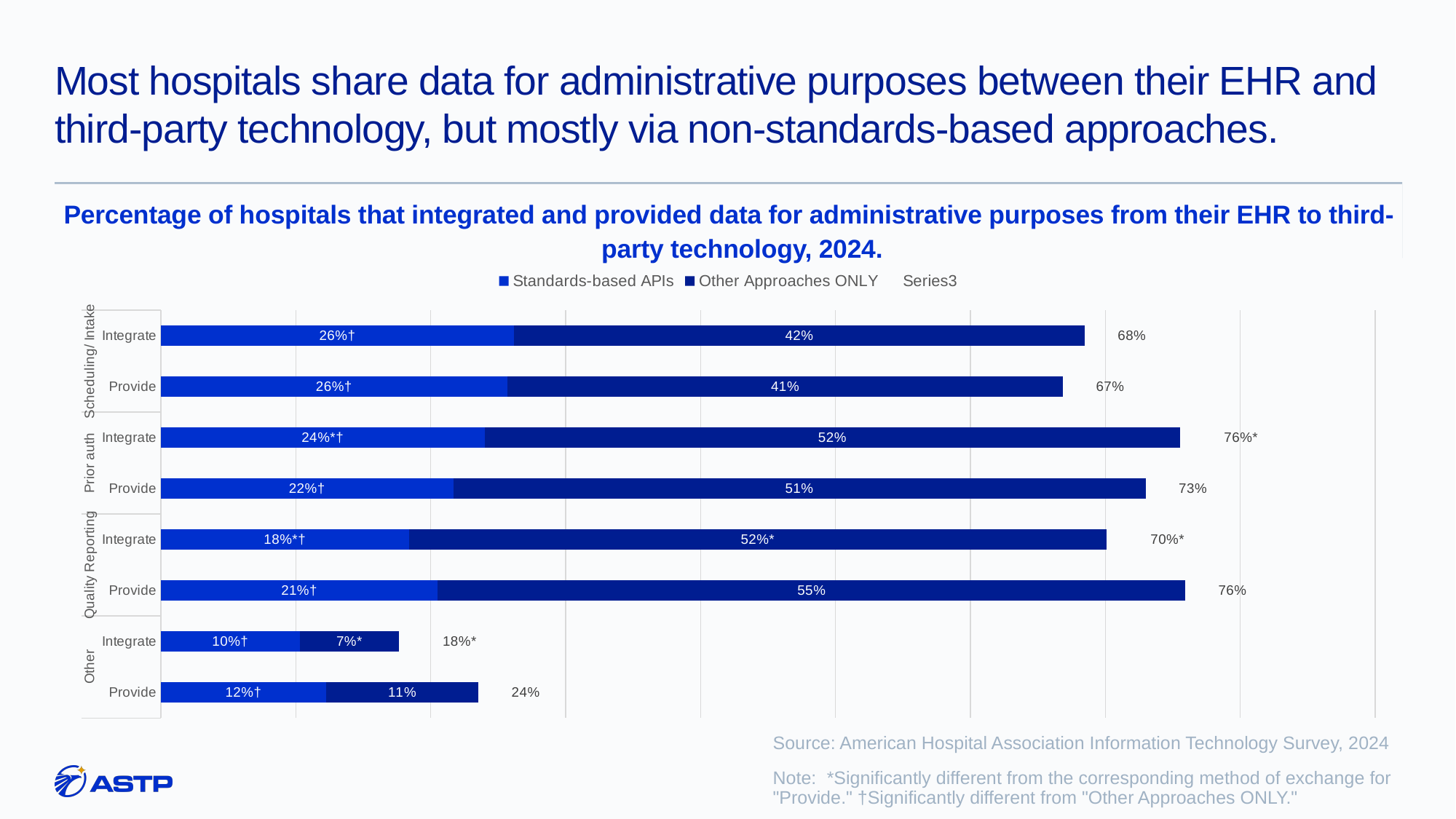
How many bars are plotted in the chart? 8 What is the difference between the Other Approaches ONLY values for Quality Reporting Provide and Scheduling/Intake Provide? 14 percentage points What type of chart is shown on the slide? Stacked bar chart What is the Other Approaches ONLY value for Prior auth Provide? 51% What is the first entry listed in the chart legend? Standards-based APIs What is the total percentage shown for Quality Reporting Provide? 76% Which bar has the lowest total percentage? Other Integrate How many series does the legend list? 3 Which is larger: the Other Approaches ONLY value for Prior auth Integrate or for Scheduling/Intake Integrate? Prior auth Integrate What is the total percentage shown for Other Integrate? 18%* What is the Standards-based APIs value for Scheduling/Intake Integrate? 26%† Which bar has the highest Other Approaches ONLY value? Quality Reporting Provide